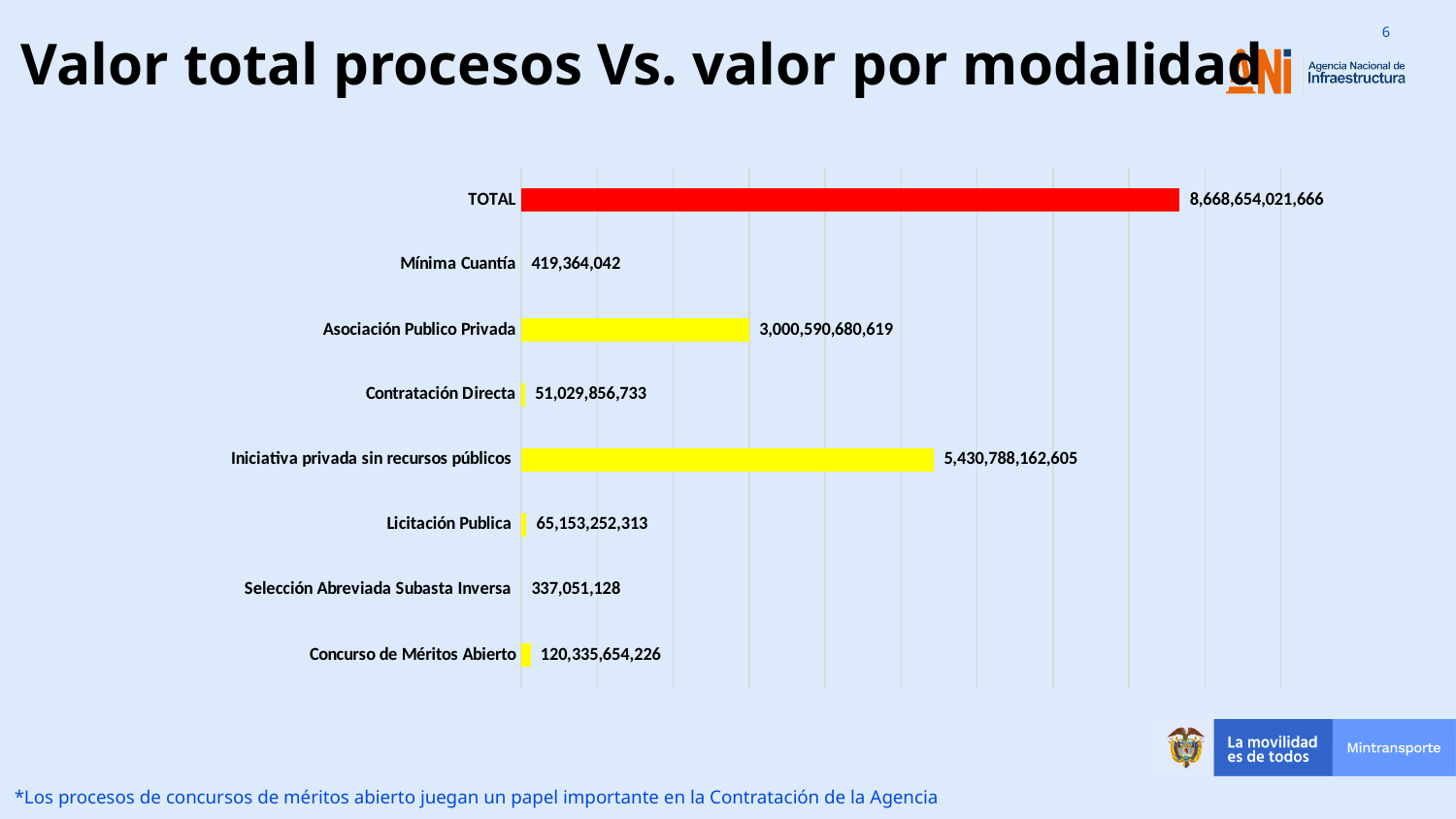
What is the value shown for Iniciativa privada sin recursos públicos? 5,430,788,162,605 Which is larger, the value for Contratación Directa or the value for Concurso de Méritos Abierto? Concurso de Méritos Abierto How many bars (categories) are shown in the chart? 8 What is the value shown for Asociación Publico Privada? 3,000,590,680,619 What is the value shown for Mínima Cuantía? 419,364,042 What is the value shown for Concurso de Méritos Abierto? 120,335,654,226 Excluding the TOTAL bar, which modality has the highest value? Iniciativa privada sin recursos públicos What is the difference between the values for Iniciativa privada sin recursos públicos and Asociación Publico Privada? 2,430,197,481,986 What type of chart is shown on the slide? Bar chart What is the difference between the values for Licitación Publica and Contratación Directa? 14,123,395,580 What is the value shown for TOTAL? 8,668,654,021,666 Which category has the lowest value in the chart? Selección Abreviada Subasta Inversa